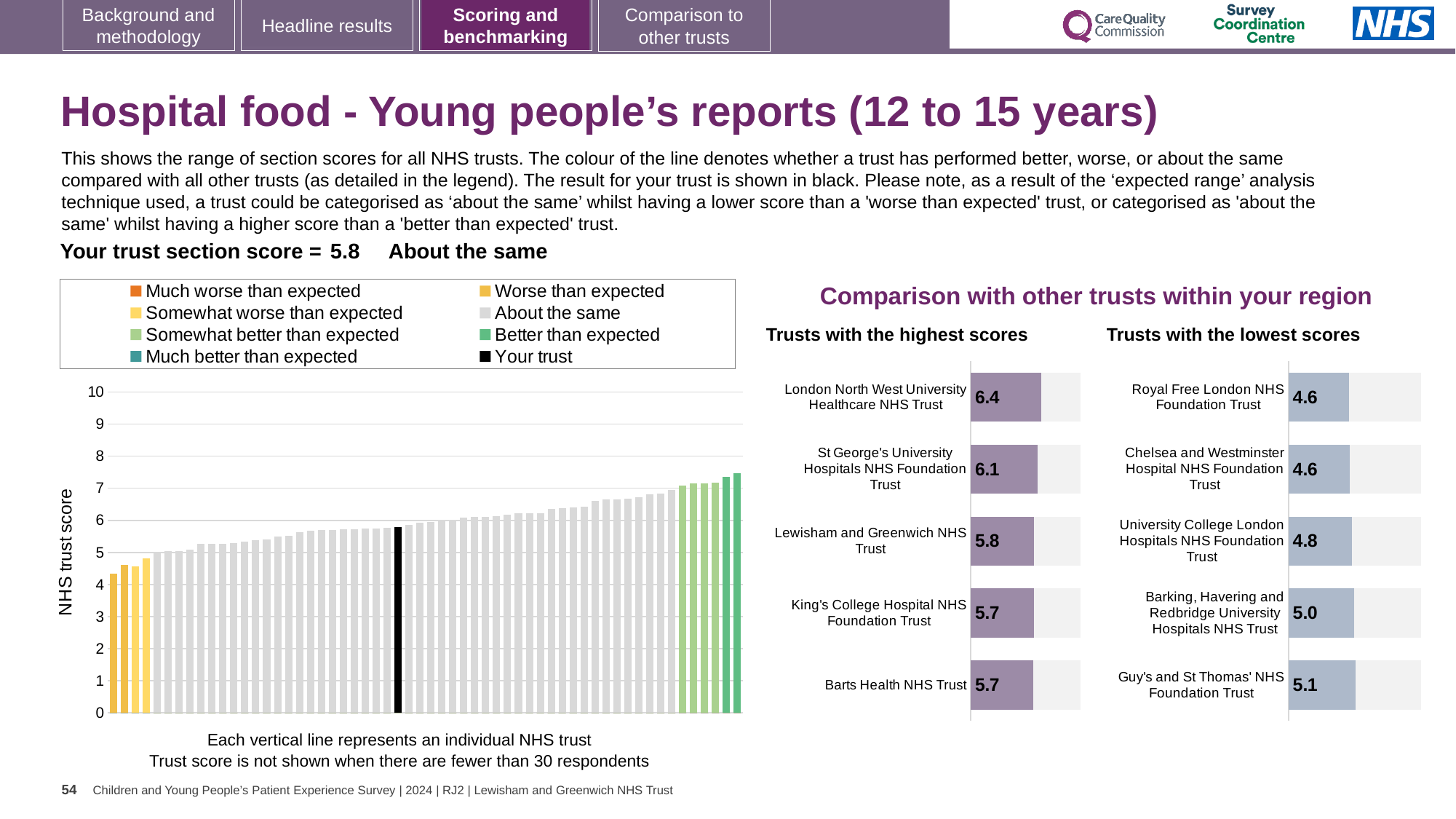
In the 'Trusts with the highest scores' chart, which trust has the highest score? London North West University Healthcare NHS Trust In the 'Trusts with the highest scores' chart, what is the score for St George's University Hospitals NHS Foundation Trust? 6.1 In the 'Trusts with the lowest scores' chart, what is the difference between the scores of Guy's and St Thomas' NHS Foundation Trust and Royal Free London NHS Foundation Trust? 0.5 In the 'Trusts with the lowest scores' chart, what is the score for Guy's and St Thomas' NHS Foundation Trust? 5.1 In the 'Trusts with the lowest scores' chart, which trust has the highest score shown? Guy's and St Thomas' NHS Foundation Trust In the main 'NHS trust score' chart, is the value of the tallest bar greater or less than 7? greater In the 'Trusts with the lowest scores' chart, what is the score for University College London Hospitals NHS Foundation Trust? 4.8 In the main 'NHS trust score' chart, is the value for the black 'Your trust' bar greater or less than 5? greater In the 'Trusts with the highest scores' chart, how many trusts are listed? 5 In the 'Trusts with the highest scores' chart, what is the difference between the scores of London North West University Healthcare NHS Trust and Lewisham and Greenwich NHS Trust? 0.6 In the 'Trusts with the highest scores' chart, what is the score for London North West University Healthcare NHS Trust? 6.4 How many entries does the legend of the main 'NHS trust score' chart list? 8